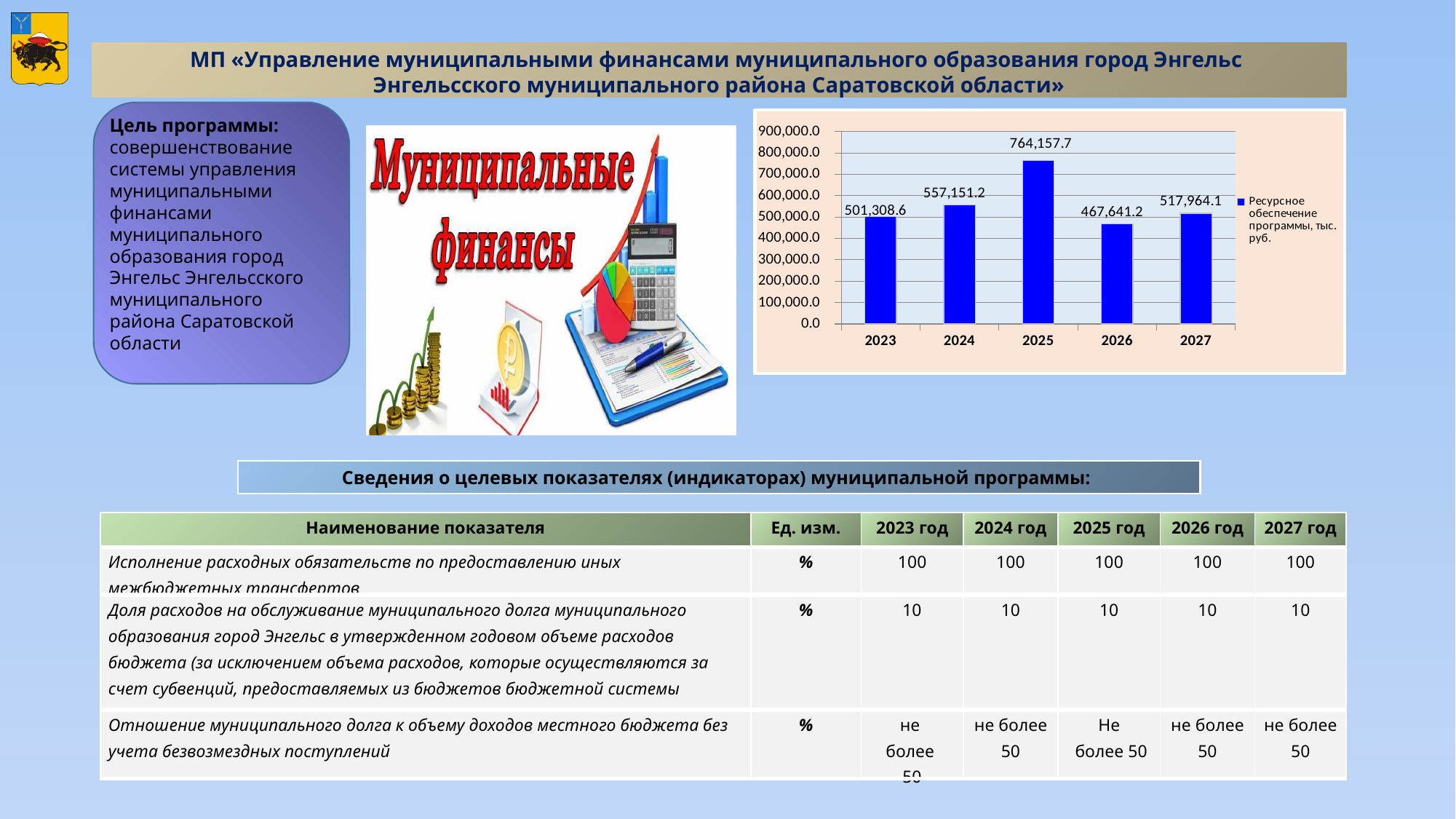
What is the difference between the values for 2027 and 2026 in the bar chart? 50,322.9 What is the value for 2023 in the bar chart? 501,308.6 How many series does the legend of the bar chart list? 1 How many years are shown on the x axis of the bar chart? 5 What is the value for 2027 in the bar chart? 517,964.1 Which is larger in the bar chart, the value for 2024 or the value for 2027? 2024 What is the value for 2025 in the bar chart? 764,157.7 What type of chart is shown on the slide? bar chart Is the value for 2026 in the bar chart greater or less than 500,000.0? less Which year has the highest value in the bar chart? 2025 What is the difference between the values for 2025 and 2024 in the bar chart? 207,006.5 Which year has the lowest value in the bar chart? 2026